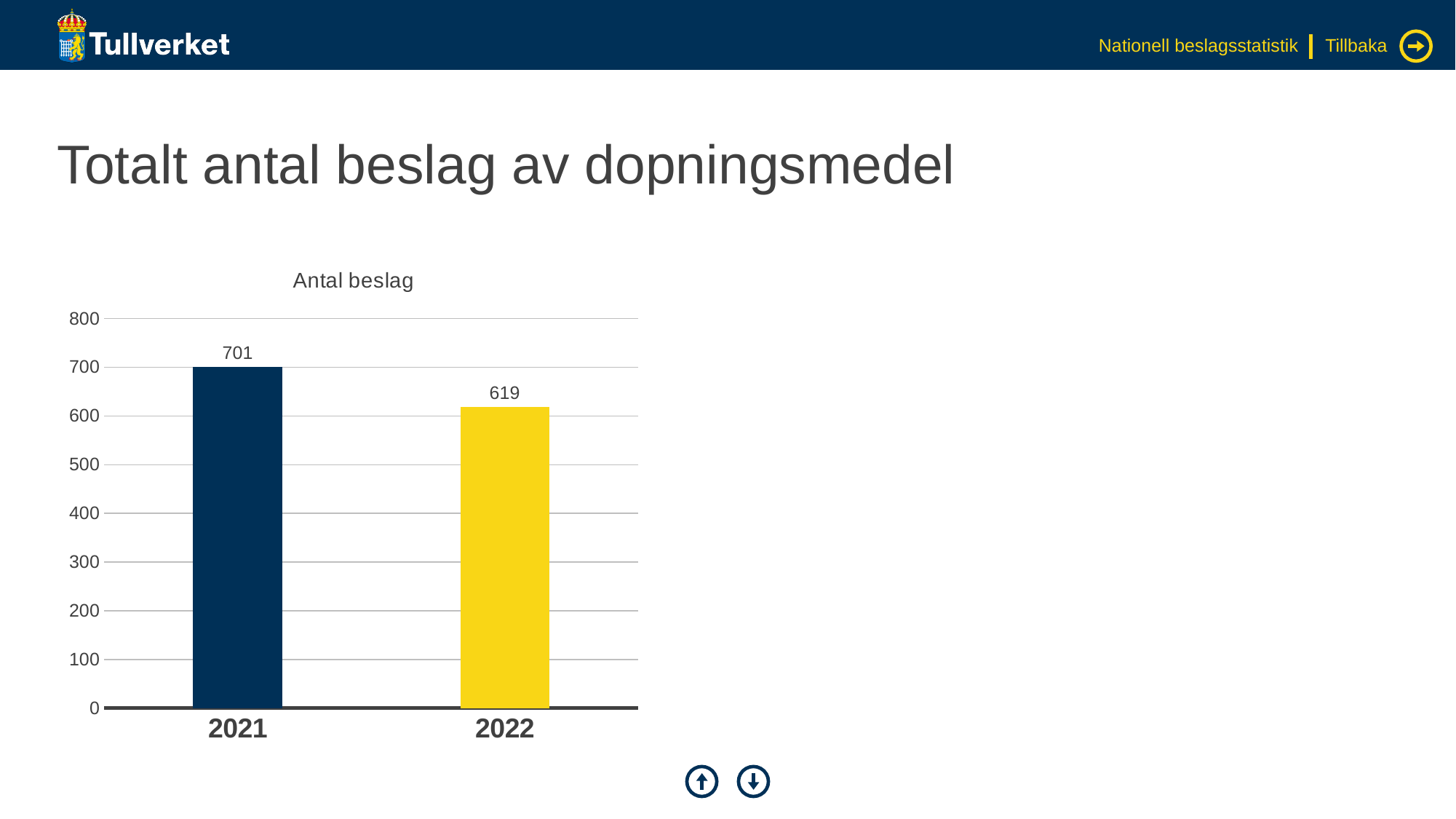
What kind of chart is shown on the slide? bar chart Is the value for 2021 greater or less than 600? greater What is the value for 2021? 701 Which year has the highest number of seizures? 2021 How many years are shown on the x axis? 2 Which year has the lowest number of seizures? 2022 Do the values rise or fall from 2021 to 2022? fall What is the difference between the values for 2021 and 2022? 82 Is the value for 2022 greater or less than 700? less What is the title of the chart? Antal beslag Which is larger, the value for 2021 or the value for 2022? 2021 What is the value for 2022? 619